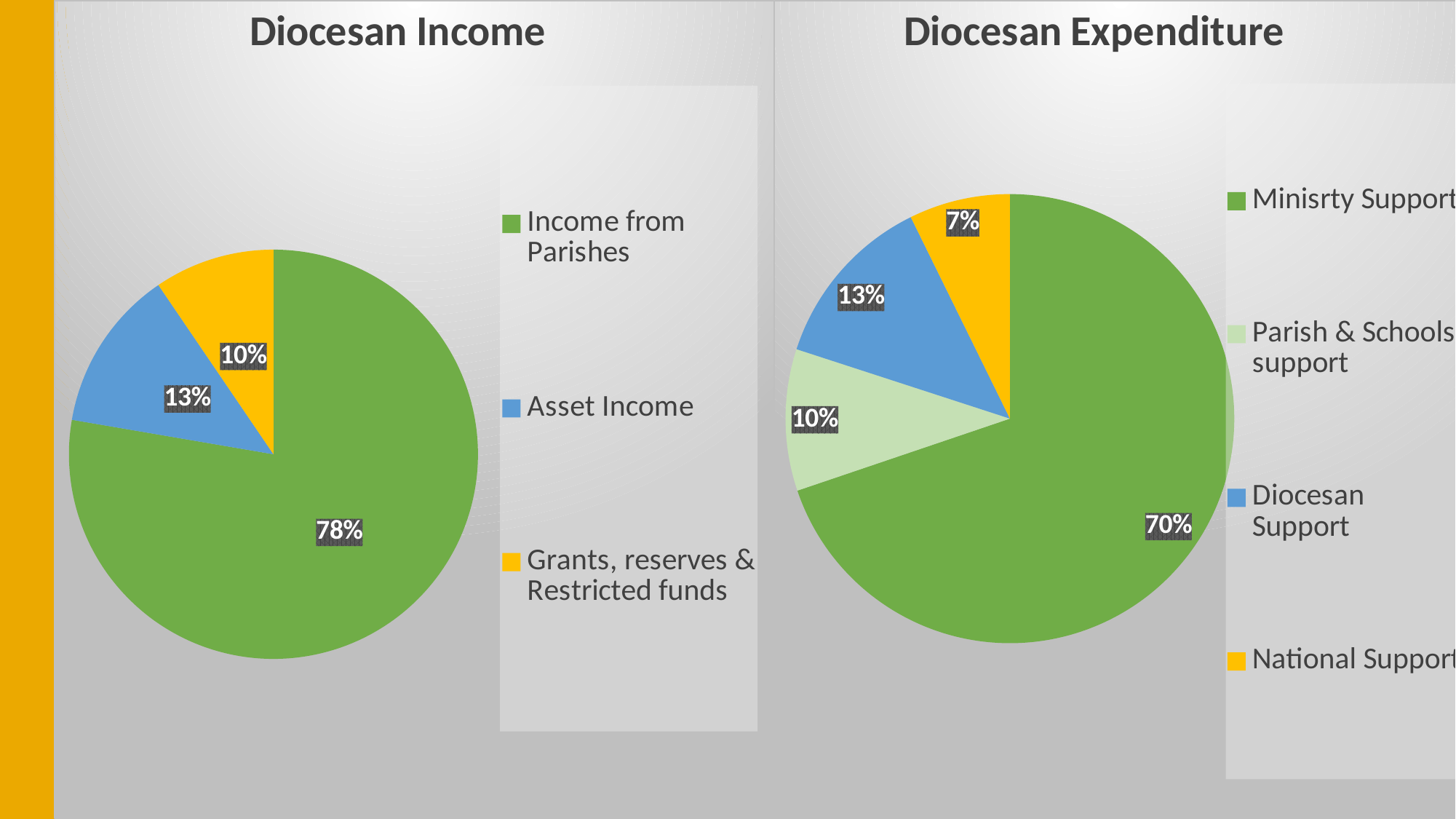
In the Diocesan Expenditure chart, how many categories does the legend list? 4 In the Diocesan Expenditure chart, what is the difference between Diocesan Support and Parish & Schools support? 3% In the Diocesan Expenditure chart, which category has the smallest share? National Support In the Diocesan Income chart, what percentage is Grants, reserves & Restricted funds? 10% In the Diocesan Income chart, how many categories are shown? 3 In the Diocesan Income chart, which category has the largest share? Income from Parishes In the Diocesan Income chart, what share of income comes from Income from Parishes? 78% In the Diocesan Income chart, what percentage is Asset Income? 13% What type of chart is the Diocesan Expenditure chart? Pie chart In the Diocesan Expenditure chart, what share of expenditure is Ministry Support? 70% In the Diocesan Income chart, which category has the smallest share? Grants, reserves & Restricted funds In the Diocesan Expenditure chart, what percentage is National Support? 7%